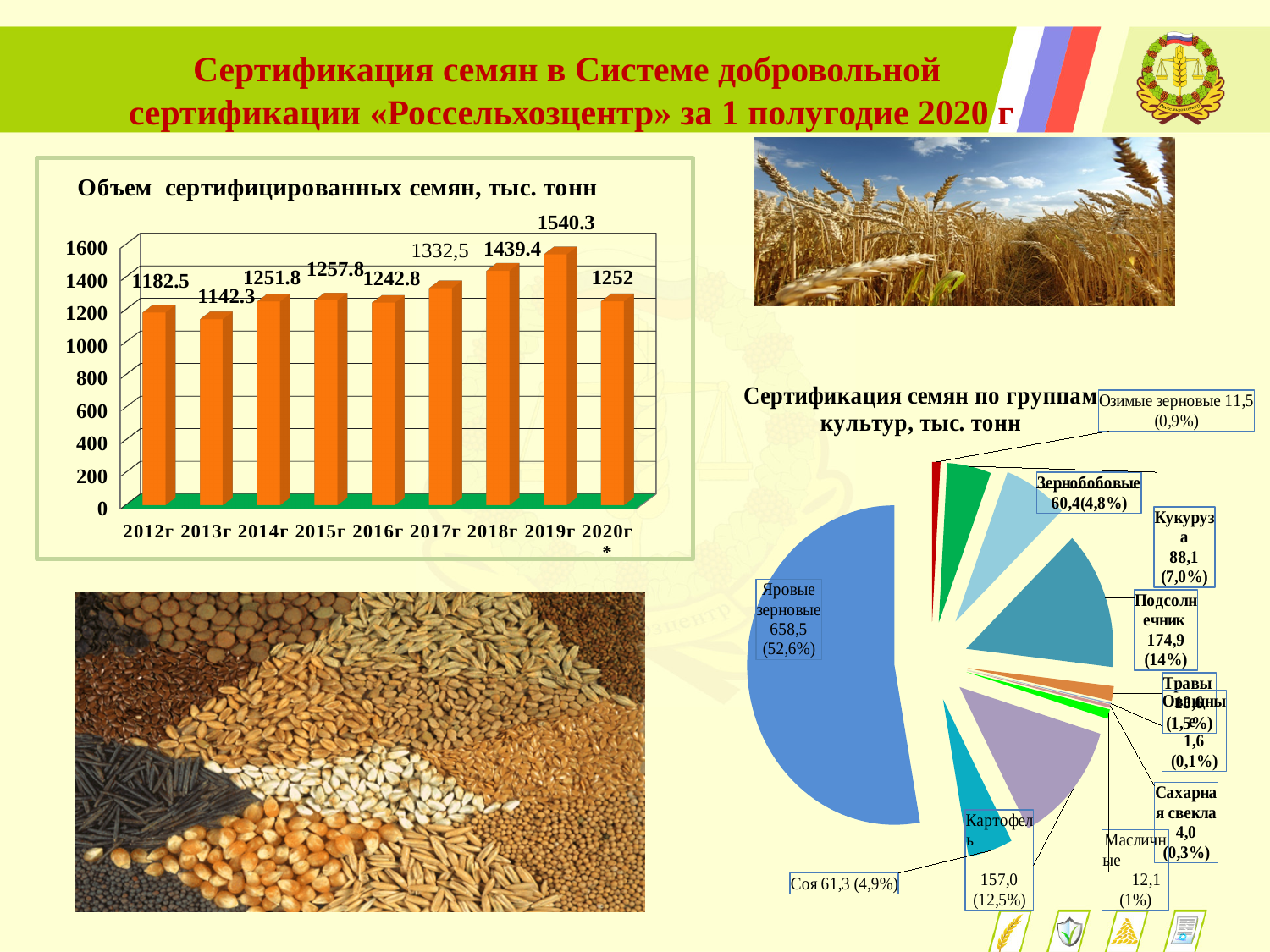
On the bar chart 'Объем сертифицированных семян, тыс. тонн', which year has the highest value? 2019г On the bar chart 'Объем сертифицированных семян, тыс. тонн', which year has the lowest value? 2013г On the bar chart 'Объем сертифицированных семян, тыс. тонн', which is larger: the value for 2015г or the value for 2016г? 2015г On the pie chart 'Сертификация семян по группам культур, тыс. тонн', which group has the largest share? Яровые зерновые What kind of chart is 'Объем сертифицированных семян, тыс. тонн'? bar chart On the bar chart 'Объем сертифицированных семян, тыс. тонн', what is the difference between the values for 2019г and 2018г? 100.9 On the bar chart 'Объем сертифицированных семян, тыс. тонн', how many years are shown? 9 On the pie chart 'Сертификация семян по группам культур, тыс. тонн', what share does Картофель have? 12,5% On the pie chart 'Сертификация семян по группам культур, тыс. тонн', what is the value for Подсолнечник? 174,9 (14%) On the bar chart 'Объем сертифицированных семян, тыс. тонн', what is the value for 2019г? 1540.3 What kind of chart is 'Сертификация семян по группам культур, тыс. тонн'? pie chart On the bar chart 'Объем сертифицированных семян, тыс. тонн', what is the value for 2012г? 1182.5